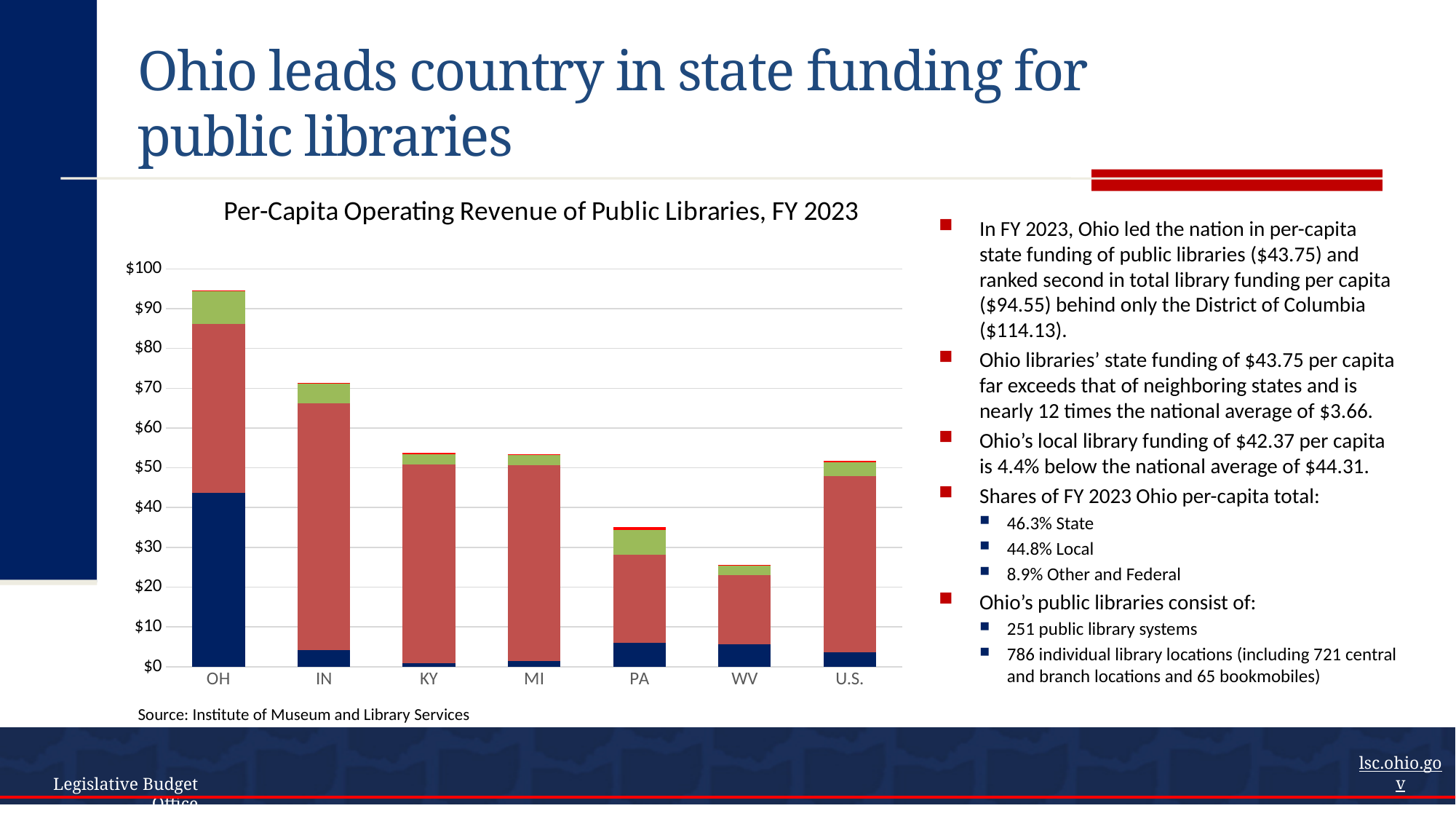
Which has the taller bar, OH or IN? OH Is the total bar for U.S. greater or less than $60? less Is the total bar for WV greater or less than $30? less What kind of chart is shown on the slide? Stacked bar chart Is the total bar for PA greater or less than $40? less Which category has the shortest bar in the chart? WV What is the title of the chart? Per-Capita Operating Revenue of Public Libraries, FY 2023 Which category has the tallest bar in the chart? OH Which has the taller bar, PA or WV? PA How many categories are shown on the x axis of the chart? 7